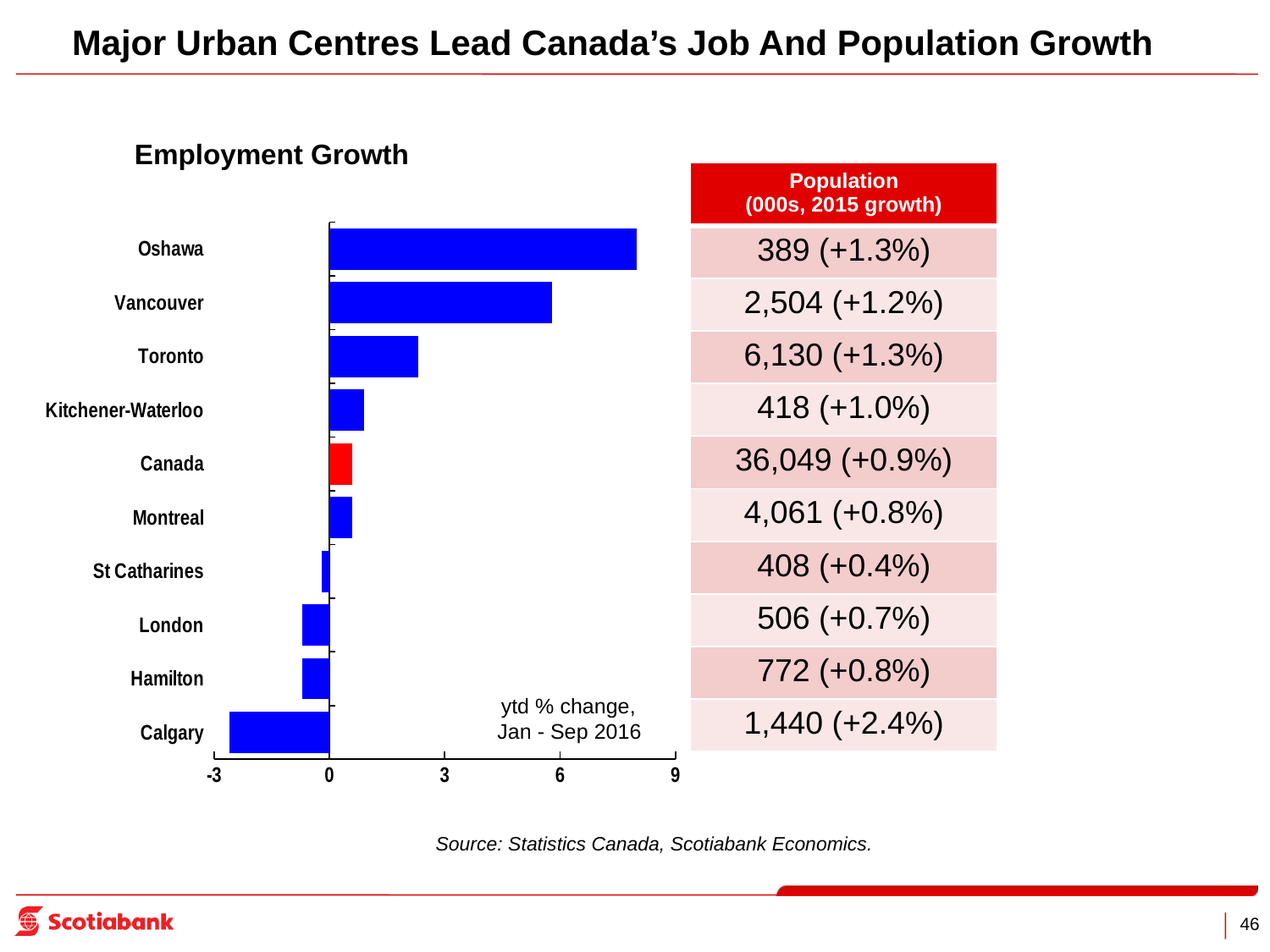
Which category's bar is coloured red on the Employment Growth chart? Canada Is the employment growth value for Vancouver greater or less than 3? greater Is the employment growth value for Toronto greater or less than 3? less How many categories are shown on the Employment Growth chart? 10 How many categories on the Employment Growth chart have negative values? 4 Is the employment growth value for Calgary greater or less than 0? less Which category has the lowest employment growth on the chart? Calgary Which has higher employment growth, Oshawa or Vancouver? Oshawa Which category has the highest employment growth on the chart? Oshawa What kind of chart is the Employment Growth chart? bar chart Which has higher employment growth, Toronto or Kitchener-Waterloo? Toronto